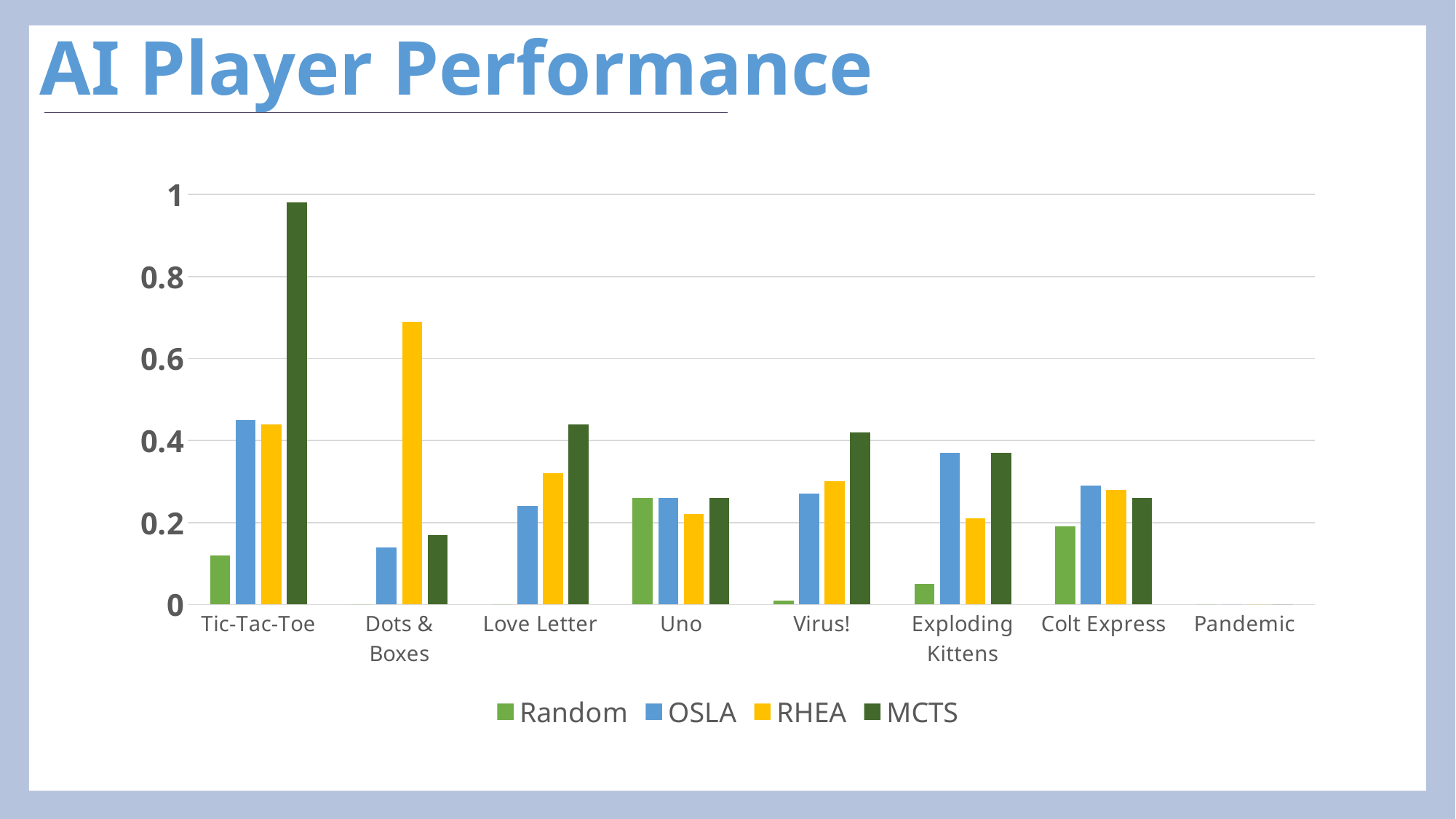
What kind of chart is shown on the slide? bar chart Which series has the highest bar for Dots & Boxes? RHEA Which series has the lowest bar for Exploding Kittens? Random Is the MCTS value for Tic-Tac-Toe greater or less than 0.8? greater What is the title of the chart? AI Player Performance Is the Random value for Virus! greater or less than 0.2? less Is the RHEA value for Dots & Boxes greater or less than 0.6? greater Which series has the highest bar for Tic-Tac-Toe? MCTS How many games (categories) are shown on the x axis? 8 For Exploding Kittens, which is larger: the Random value or the OSLA value? OSLA How many series does the legend list? 4 For which game is the MCTS bar the tallest? Tic-Tac-Toe